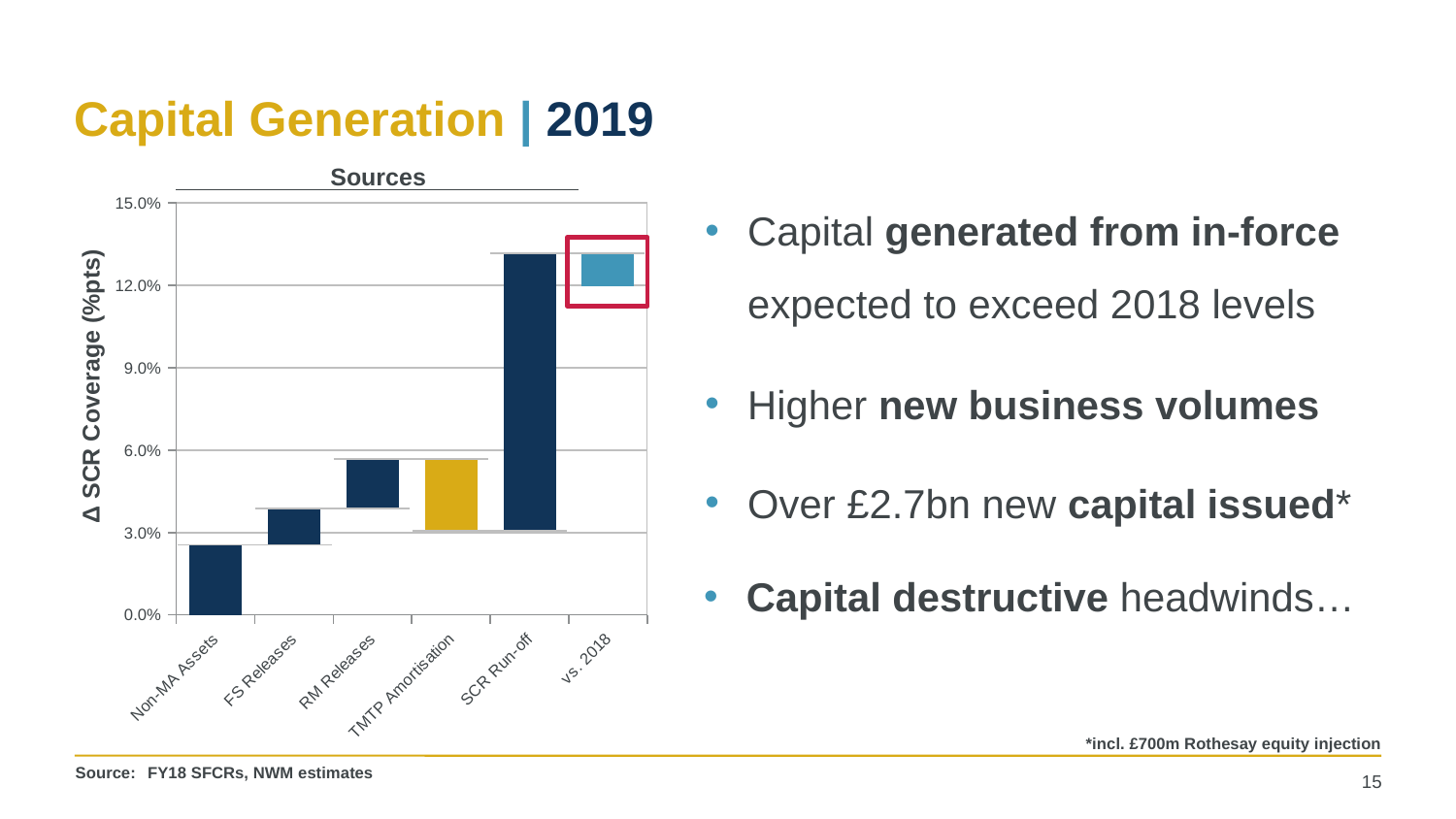
How many categories are shown on the x axis of the chart? 6 Does the top of the SCR Run-off bar reach greater or less than 15.0%? less Which category has the tallest bar in the chart? SCR Run-off What kind of chart is shown on the slide? Bar chart Does the top of the SCR Run-off bar reach greater or less than 12.0%? greater What is the label on the y axis of the chart? Δ SCR Coverage (%pts) What is the title of the chart? Sources Does the top of the vs. 2018 bar reach greater or less than 9.0%? greater Which category's bar is taller, SCR Run-off or RM Releases? SCR Run-off